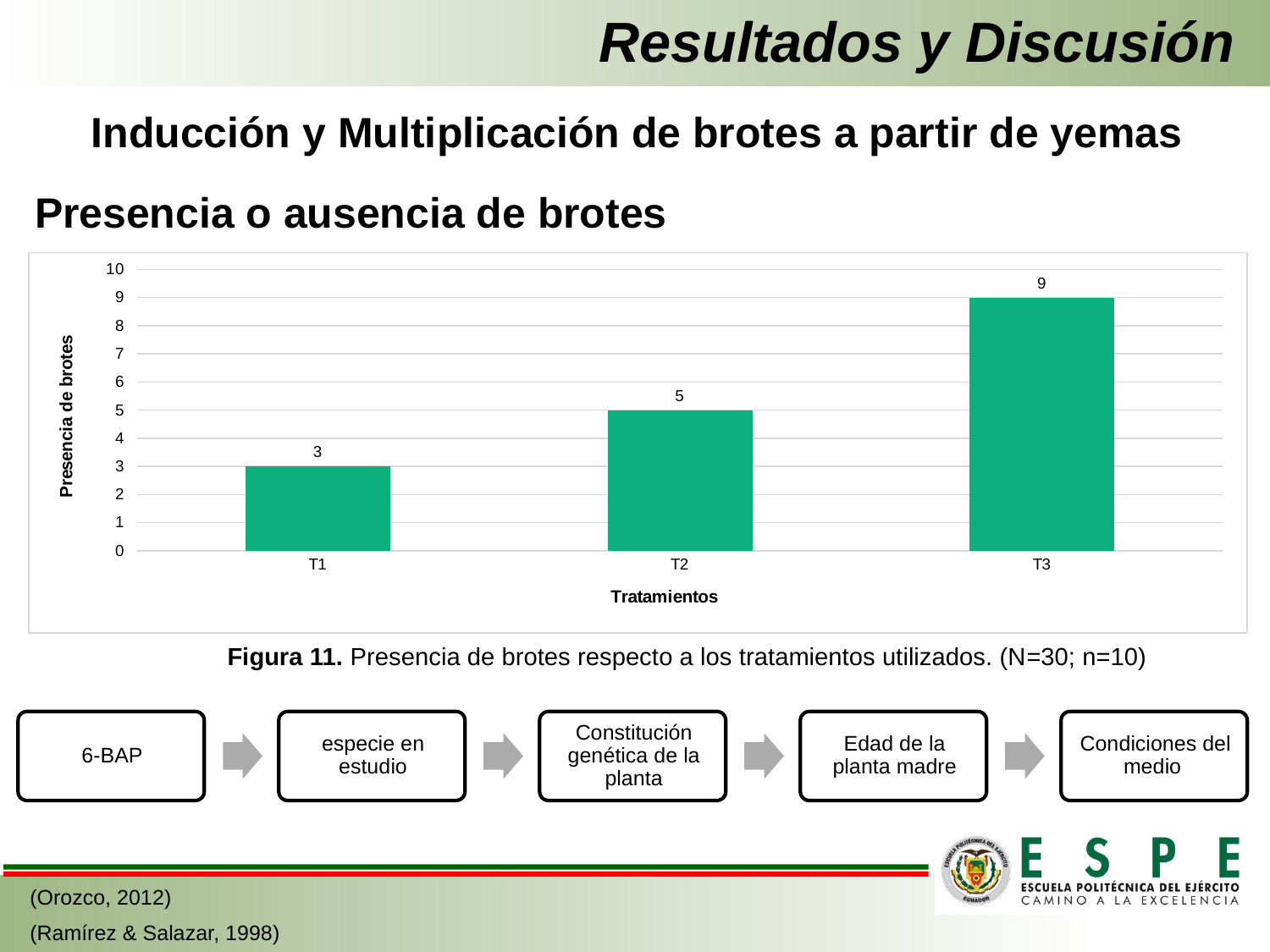
How many treatments are shown on the x axis? 3 Do the values rise or fall from T1 to T3? rise What is the difference between the values for T3 and T1? 6 What is the value for T3? 9 What is the difference between the values for T2 and T1? 2 What kind of chart is shown? bar chart What is the label of the y axis? Presencia de brotes What is the value for T1? 3 Which is larger, the value for T2 or the value for T3? T3 What is the value for T2? 5 Which treatment has the lowest presence of brotes? T1 Which treatment has the highest presence of brotes? T3